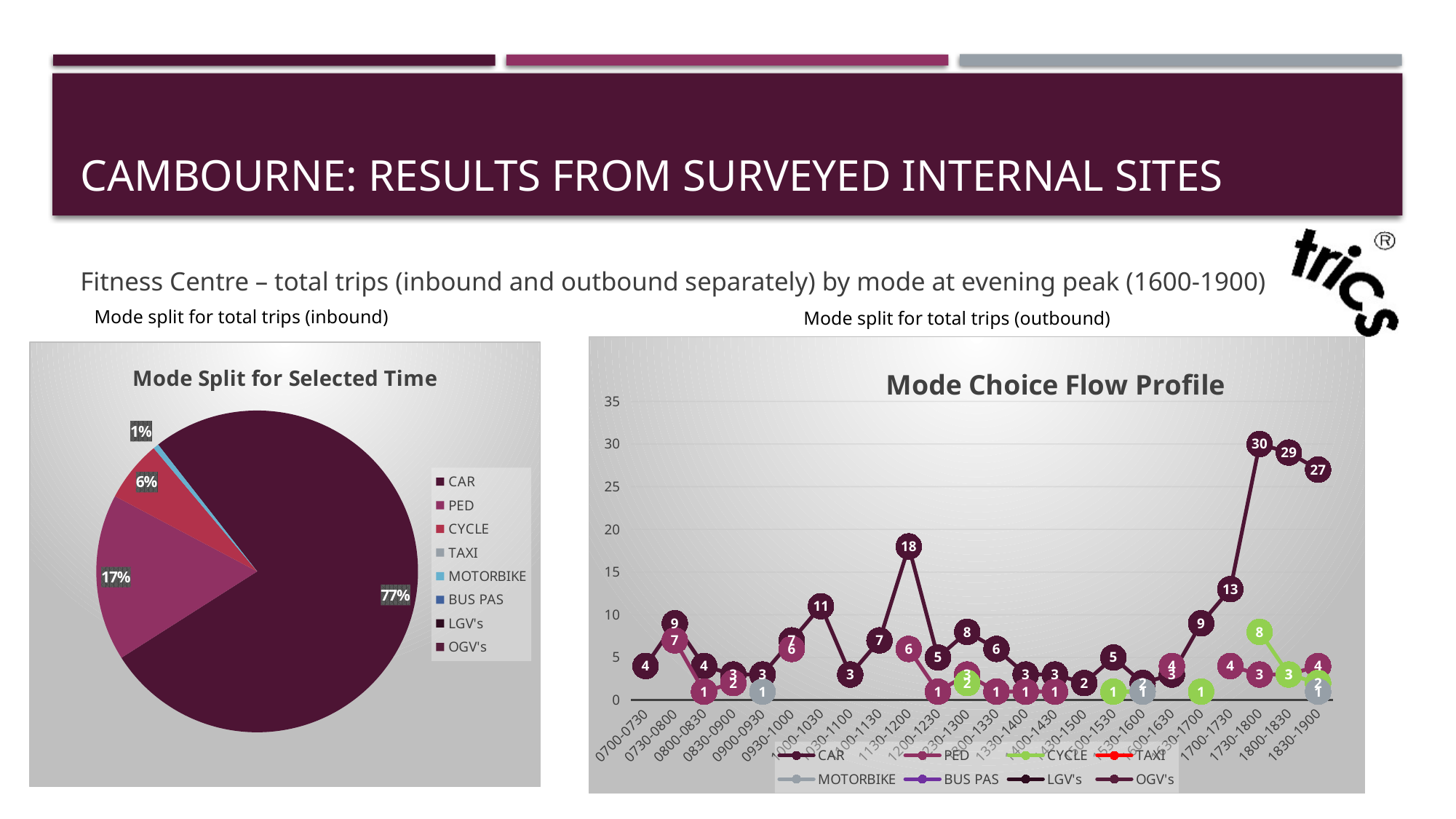
What kind of chart is 'Mode Split for Selected Time'? Pie chart In the pie chart 'Mode Split for Selected Time', which mode has the largest share? CAR In the 'Mode Choice Flow Profile' chart, how many series does the legend list? 8 In the 'Mode Choice Flow Profile' chart, what is the CYCLE value for the 1730-1800 time slot? 8 In the pie chart 'Mode Split for Selected Time', what percentage of trips is by PED? 17% In the pie chart 'Mode Split for Selected Time', what percentage of trips is by CAR? 77% What kind of chart is 'Mode Choice Flow Profile'? Line chart How many entries does the legend of the pie chart 'Mode Split for Selected Time' list? 8 In the 'Mode Choice Flow Profile' chart, what is the difference between the CAR values at 1730-1800 and 1830-1900? 3 In the pie chart 'Mode Split for Selected Time', what percentage of trips is by CYCLE? 6% In the 'Mode Choice Flow Profile' chart, what is the CAR value for the 1130-1200 time slot? 18 In the 'Mode Choice Flow Profile' chart, what is the CAR value for the 1730-1800 time slot? 30